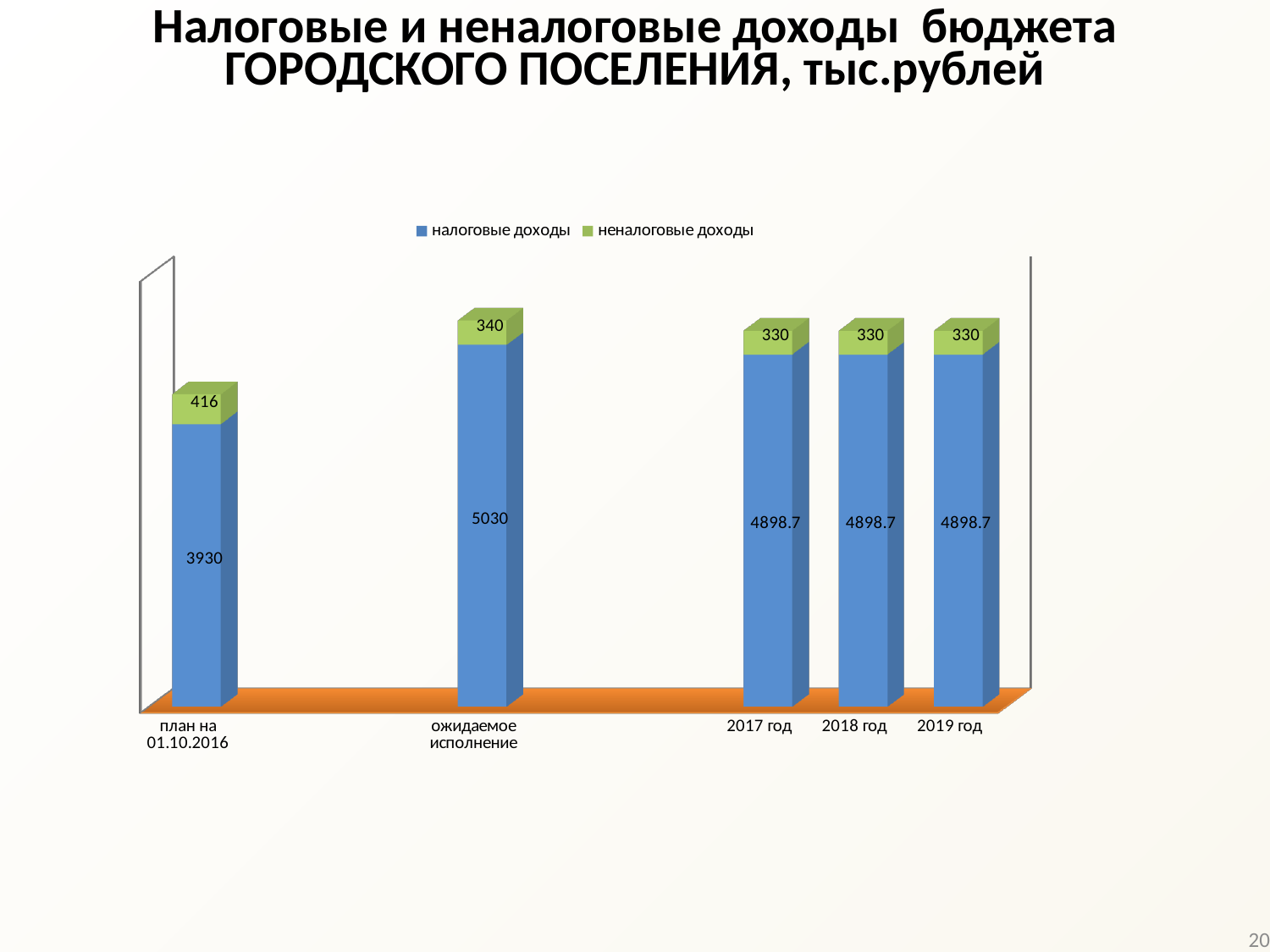
Which is larger: неналоговые доходы for план на 01.10.2016 or for 2017 год? план на 01.10.2016 What is the total of the stacked bar for ожидаемое исполнение? 5370 What is the difference between налоговые доходы for ожидаемое исполнение and for план на 01.10.2016? 1100 What is the value of налоговые доходы for 2018 год? 4898.7 What kind of chart is shown on the slide? stacked bar chart Which colour represents неналоговые доходы in the legend? green Which category has the highest value of налоговые доходы? ожидаемое исполнение How many series does the legend list? 2 How many categories are shown on the x axis? 5 Which category has the lowest value of налоговые доходы? план на 01.10.2016 What is the value of налоговые доходы for план на 01.10.2016? 3930 What is the value of неналоговые доходы for ожидаемое исполнение? 340